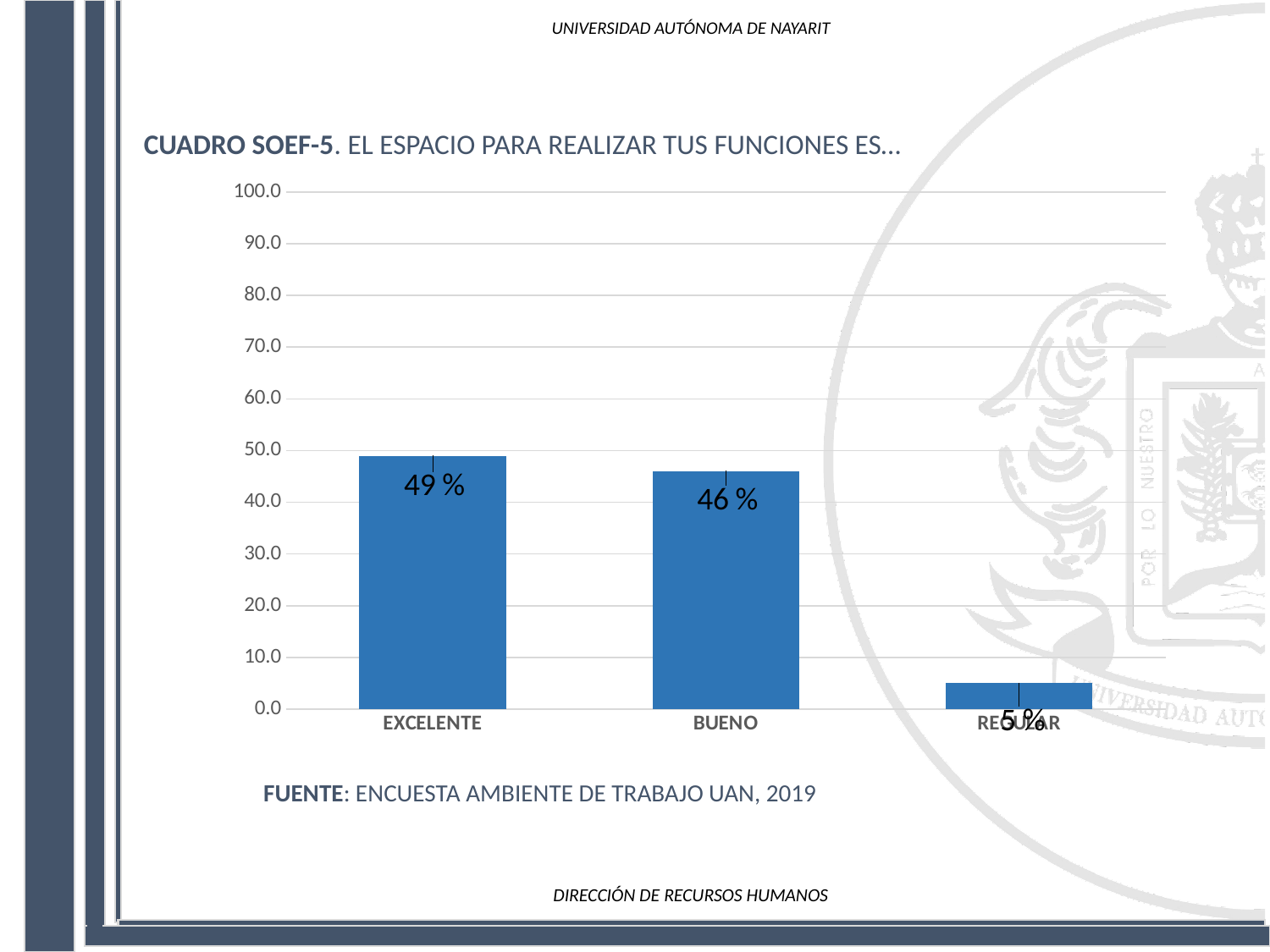
Which category has the lowest value? REGULAR What is the difference between the values for BUENO and REGULAR? 41 % Is the value for BUENO greater or less than 50.0? less How many categories are shown on the x axis? 3 What kind of chart is shown on the slide? bar chart What is the value for EXCELENTE? 49 % What is the value for BUENO? 46 % What is the difference between the values for EXCELENTE and BUENO? 3 % What is the source cited below the chart? ENCUESTA AMBIENTE DE TRABAJO UAN, 2019 What is the value for REGULAR? 5 % Which category has the highest value? EXCELENTE Which is larger, the value for EXCELENTE or the value for BUENO? EXCELENTE